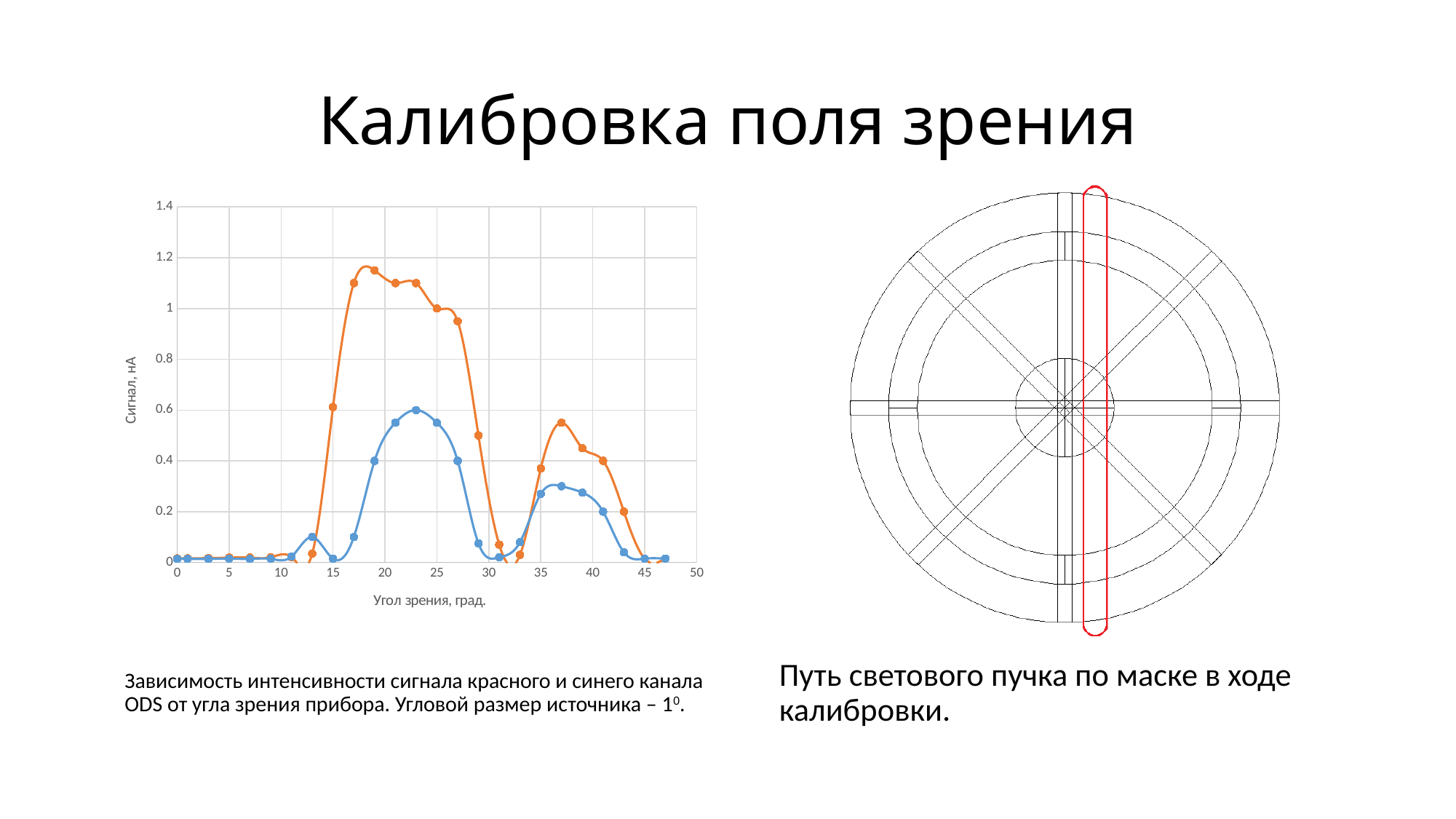
Is the value of the blue series at an angle of 15 degrees greater or less than 0.2? less What is the label of the vertical axis of the chart? Сигнал, нА Is the value of the orange series at an angle of 27 degrees greater or less than 1? less Is the value of the orange series at an angle of 37 degrees greater or less than 0.4? greater Which series reaches the higher peak value, the orange or the blue? orange What is the label of the horizontal axis of the chart? Угол зрения, град. At an angle of 23 degrees, which series has the larger value, the orange or the blue? orange What kind of chart is shown on the left of the slide? line chart Does the orange series rise or fall as the angle goes from 27 to 31 degrees? fall